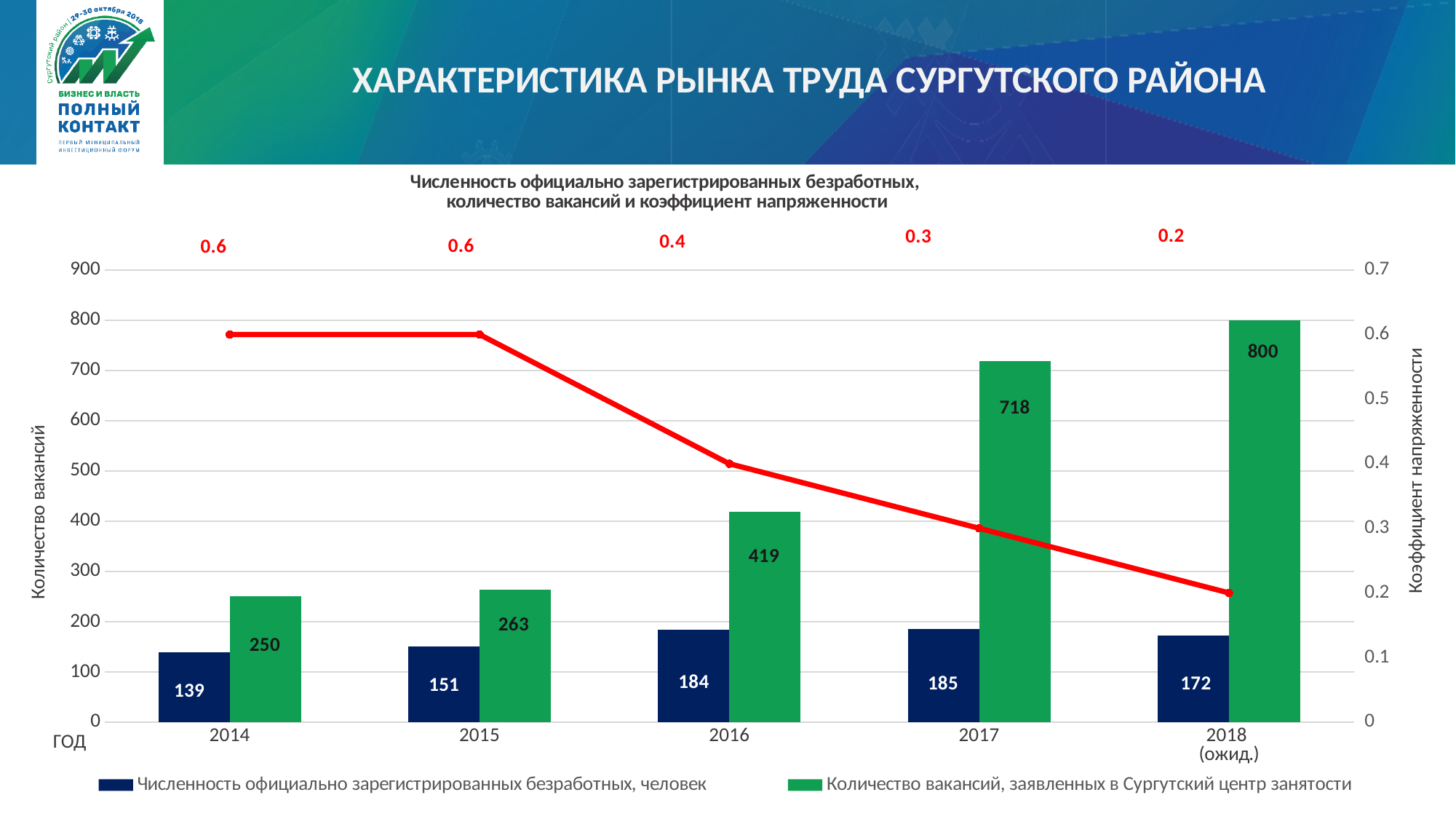
How many series does the legend list? 2 Which is larger in 2015: the number of registered unemployed or the number of vacancies? Количество вакансий (263) What is the difference between the number of vacancies in 2018 (ожид.) and in 2017? 82 In which year is the number of vacancies highest? 2018 (ожид.) Does the tension coefficient (red line) rise or fall from 2014 to 2018? Fall How many years are shown on the x axis? 5 What kind of chart is this? Combined bar and line chart How many vacancies (Количество вакансий) were declared in 2017? 718 What is the label of the right-hand vertical axis? Коэффициент напряженности What is the number of officially registered unemployed (Численность официально зарегистрированных безработных) in 2016? 184 In which year is the number of registered unemployed lowest? 2014 What is the tension coefficient (коэффициент напряженности) shown for 2014? 0.6